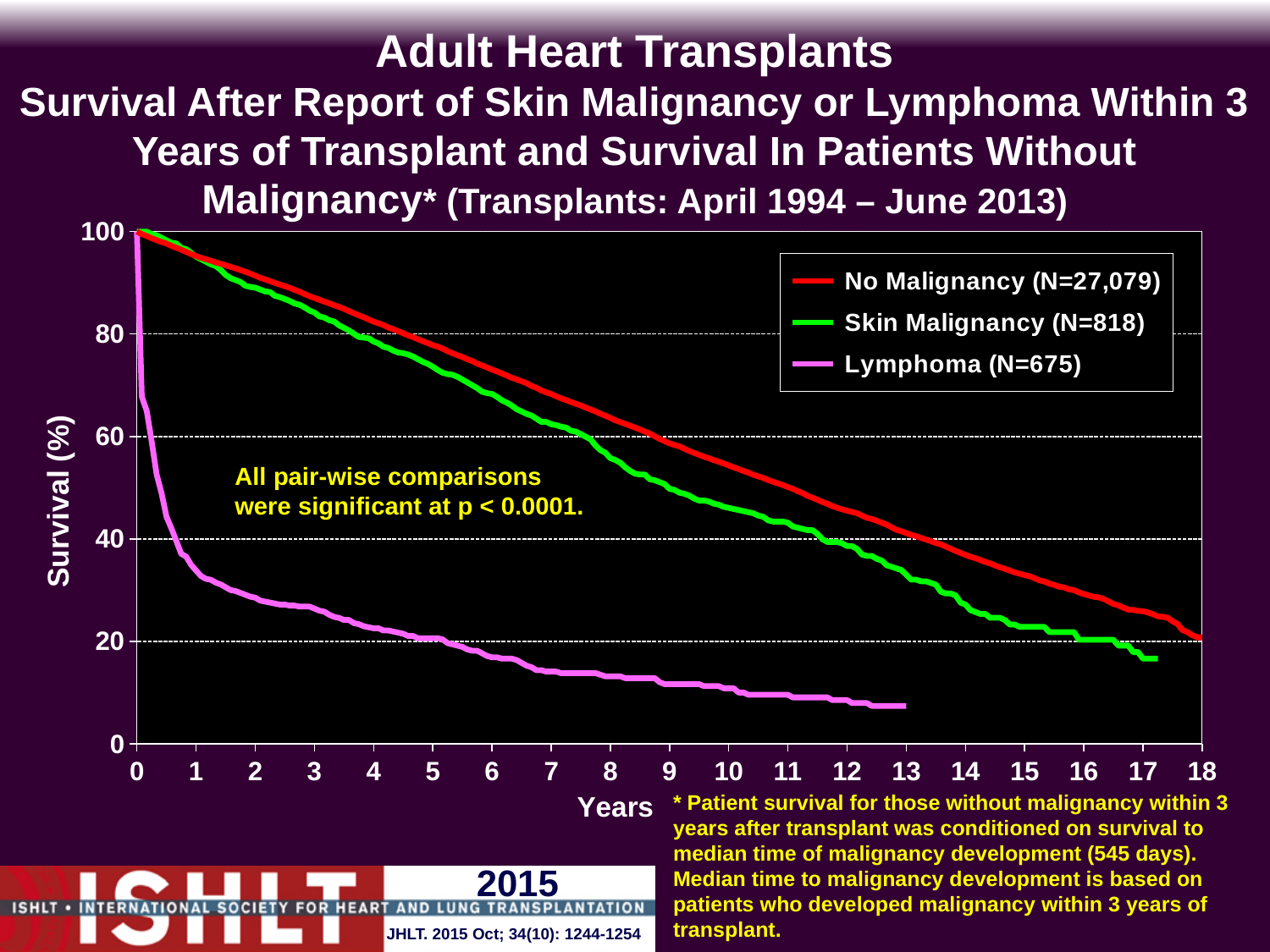
What is the N for the No Malignancy group shown in the legend? 27,079 What kind of chart is shown on the slide? Line chart Which group has the lowest survival curve across the chart? Lymphoma Which group has the highest survival curve across the chart? No Malignancy How many series does the legend list? 3 What colour is the line for the Skin Malignancy group? Green Do the survival curves rise or fall as years increase? fall Is the survival for the Lymphoma group at 10 years greater or less than 20? less What is the N for the Lymphoma group shown in the legend? 675 Is the survival for the No Malignancy group at 10 years greater or less than 40? greater Is the survival for the Skin Malignancy group at 5 years greater or less than 60? greater What is the N for the Skin Malignancy group shown in the legend? 818